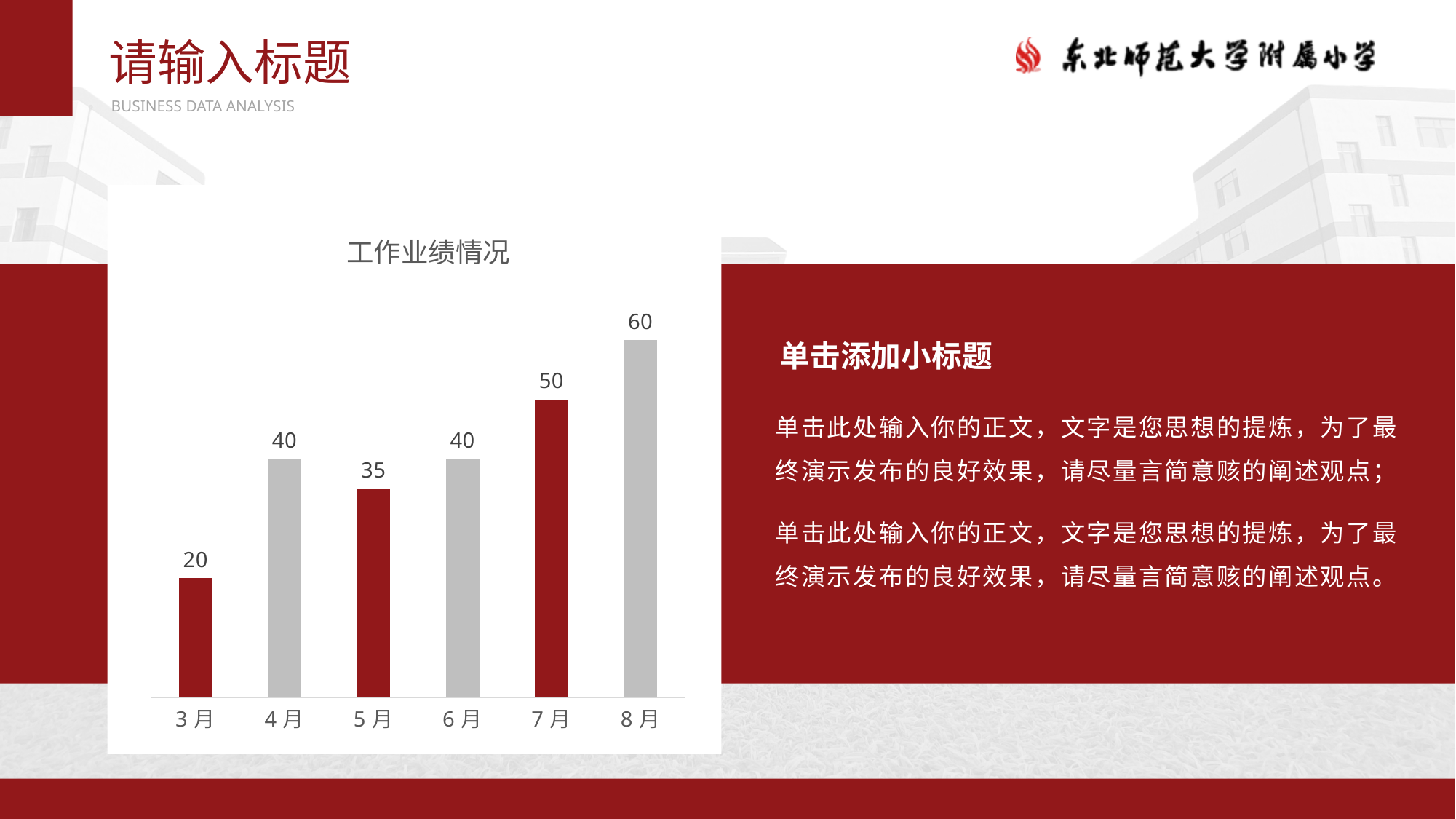
What is the difference between the values for 8月 and 3月? 40 Which is larger, the value for 4月 or the value for 5月? 4月 How many months are shown on the x axis? 6 Which month has the lowest value? 3月 Do the values generally rise or fall from 3月 to 8月? Rise What is the value for 7月? 50 What is the title of the chart? 工作业绩情况 What is the difference between the values for 7月 and 5月? 15 What is the value for 3月? 20 Which month has the highest value? 8月 What is the value for 5月? 35 What kind of chart is shown on the slide? Bar chart